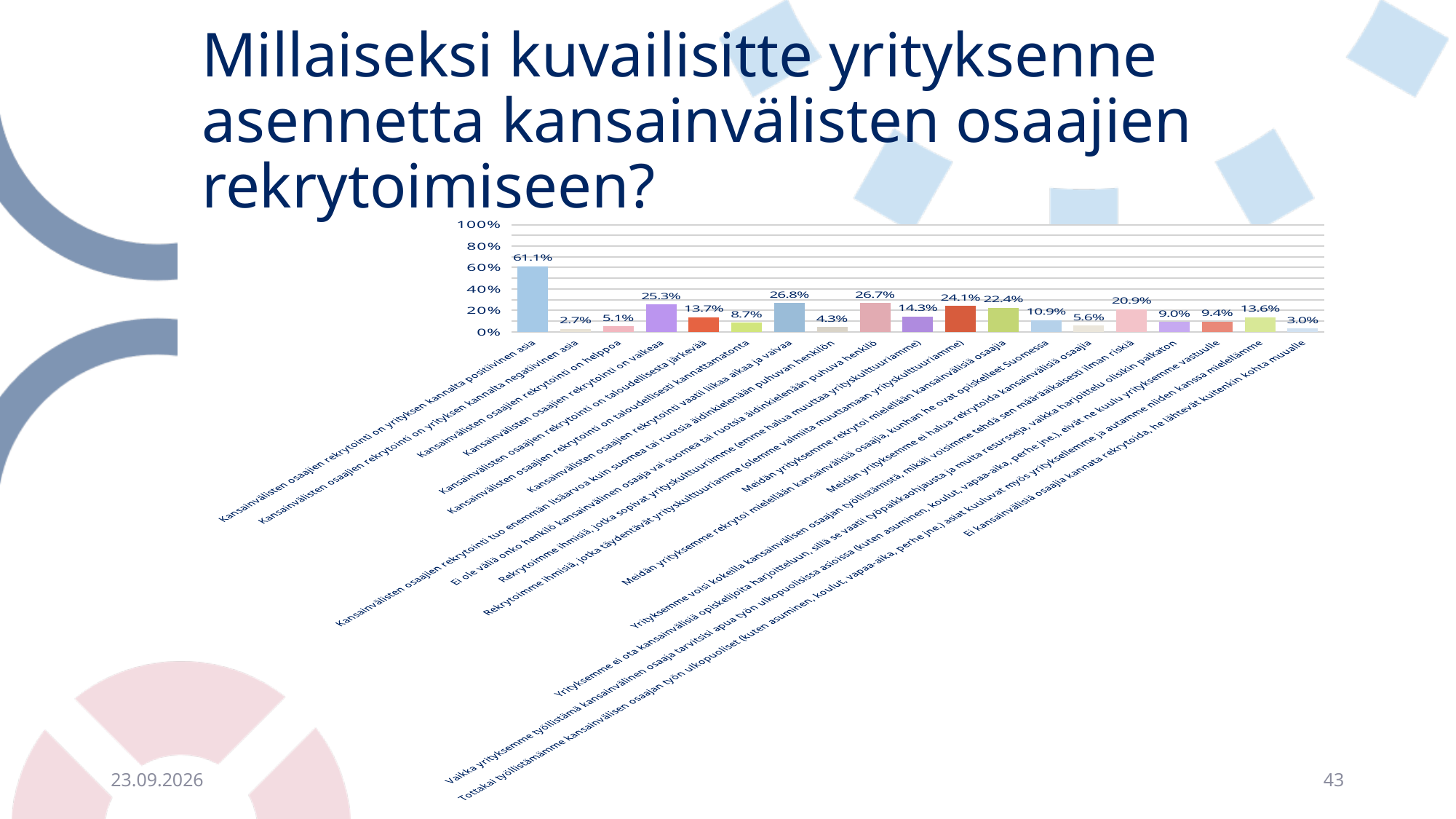
Which category has the highest value? Kansainvälisten osaajien rekrytointi on yrityksen kannalta positiivinen asia Which category has the lowest value? Kansainvälisten osaajien rekrytointi on yrityksen kannalta negatiivinen asia What type of chart is shown on the slide? bar chart What is the value for "Kansainvälisten osaajien rekrytointi on yrityksen kannalta positiivinen asia"? 61.1% What is the value for "Kansainvälisten osaajien rekrytointi on vaikeaa"? 25.3% What is the value for "Kansainvälisten osaajien rekrytointi vaatii liikaa aikaa ja vaivaa"? 26.8% What is the value for "Meidän yrityksemme ei halua rekrytoida kansainvälisiä osaajia"? 5.6% What is the difference between the values for "Kansainvälisten osaajien rekrytointi on vaikeaa" and "Kansainvälisten osaajien rekrytointi on helppoa"? 20.2% What is the highest value shown on the vertical axis? 100% Is the value for "Kansainvälisten osaajien rekrytointi on yrityksen kannalta positiivinen asia" greater or less than 40%? greater How many categories (bars) are shown in the chart? 19 Which is larger: the value for "Meidän yrityksemme rekrytoi mielellään kansainvälisiä osaajia" or for "Meidän yrityksemme rekrytoi mielellään kansainvälisiä osaajia, kunhan he ovat opiskelleet Suomessa"? Meidän yrityksemme rekrytoi mielellään kansainvälisiä osaajia